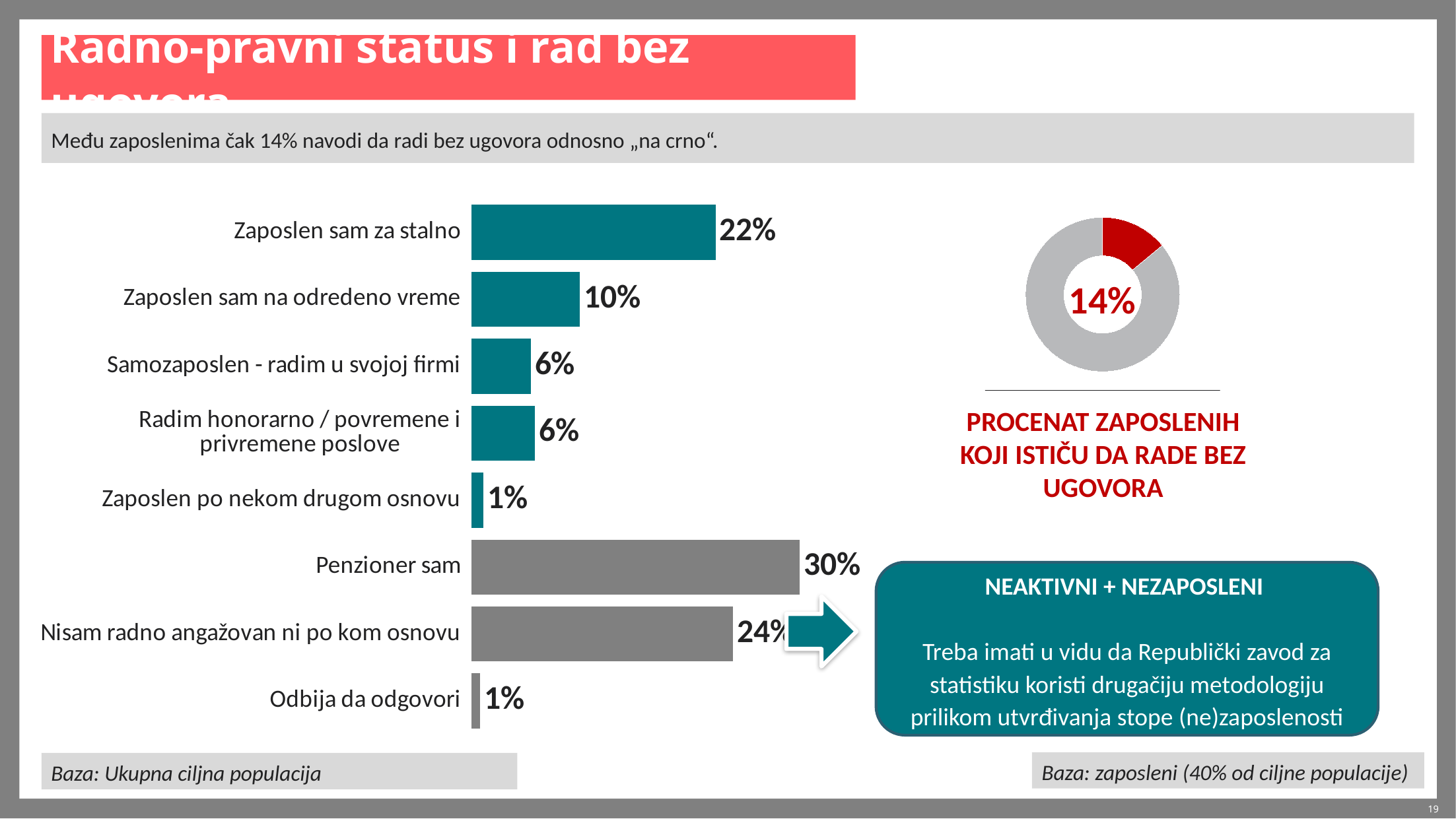
In the bar chart on the left, which is larger: "Zaposlen sam za stalno" or "Nisam radno angažovan ni po kom osnovu"? Nisam radno angažovan ni po kom osnovu In the bar chart on the left, which category has the highest value? Penzioner sam In the bar chart on the left, what is the value for "Zaposlen sam za stalno"? 22% What kind of chart is shown on the left side of the slide? Bar chart In the bar chart on the left, what is the difference between "Zaposlen sam na odredeno vreme" and "Samozaposlen - radim u svojoj firmi"? 4% What value is shown in the donut chart on the right? 14% In the bar chart on the left, what is the value for "Nisam radno angažovan ni po kom osnovu"? 24% In the bar chart on the left, what colour are the bars for "Penzioner sam" and "Nisam radno angažovan ni po kom osnovu"? Grey In the bar chart on the left, how many categories are shown? 8 In the bar chart on the left, what is the value for "Penzioner sam"? 30% In the bar chart on the left, what is the difference between "Penzioner sam" and "Zaposlen sam za stalno"? 8% In the bar chart on the left, what is the value for "Zaposlen sam na odredeno vreme"? 10%